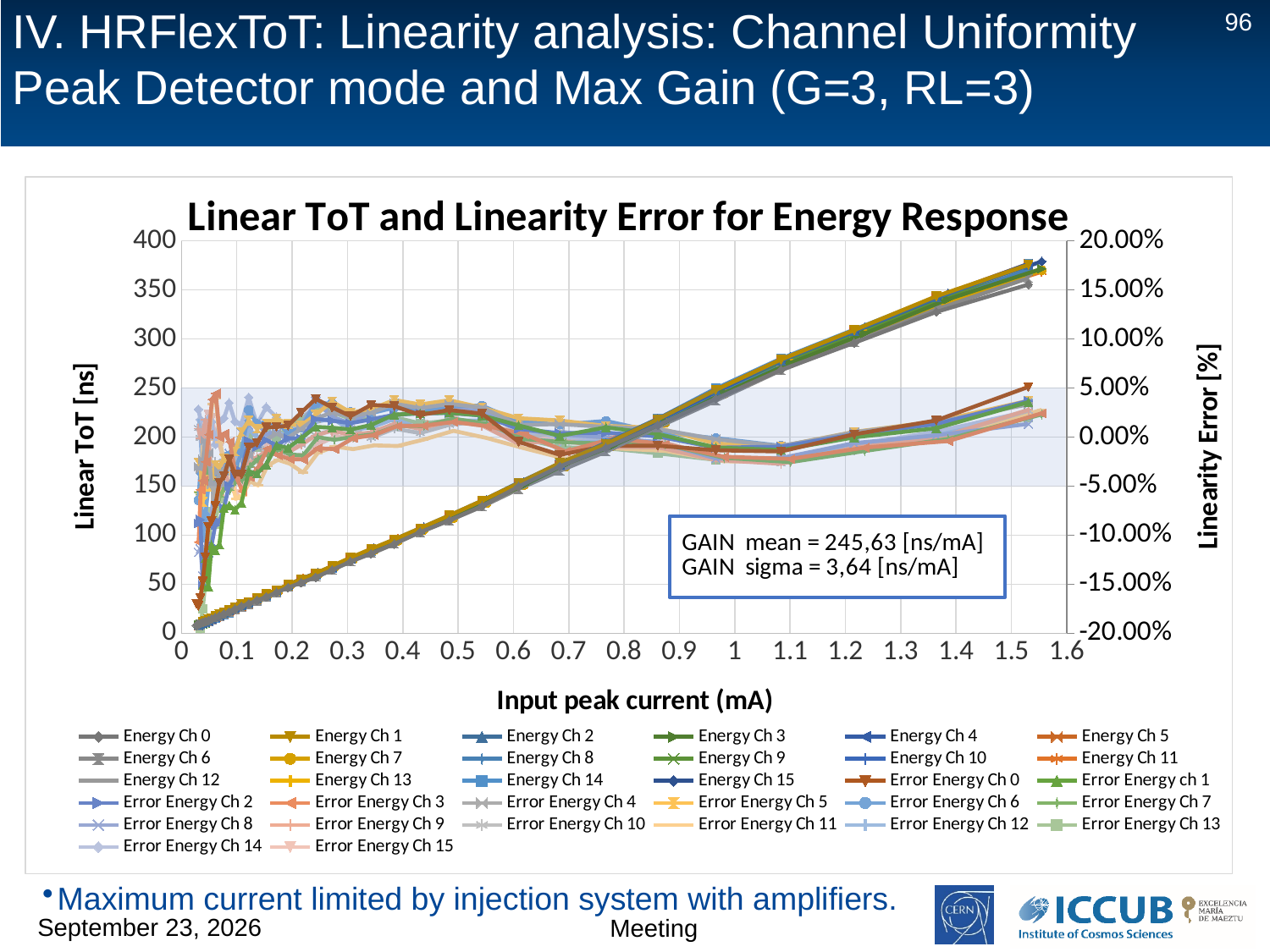
How many 'Energy Ch' series (excluding the error series) does the legend list? 16 Is the Linear ToT value for Energy Ch 1 at 1 mA greater or less than 200? greater What is the GAIN mean value stated in the text box on the chart? 245,63 [ns/mA] What is the title of the chart? Linear ToT and Linearity Error for Energy Response How many series does the chart legend list? 32 Is the Linear ToT value for Energy Ch 0 at 0.5 mA greater or less than 150? less What is the GAIN sigma value stated in the text box on the chart? 3,64 [ns/mA] What is the label of the x axis? Input peak current (mA) Do the Energy Ch series rise or fall as the input peak current increases? rise What kind of chart is shown on the slide? line chart Is the Linear ToT value for Energy Ch 15 at 1.5 mA greater or less than 350? greater What is the maximum value shown on the left (Linear ToT) axis? 400